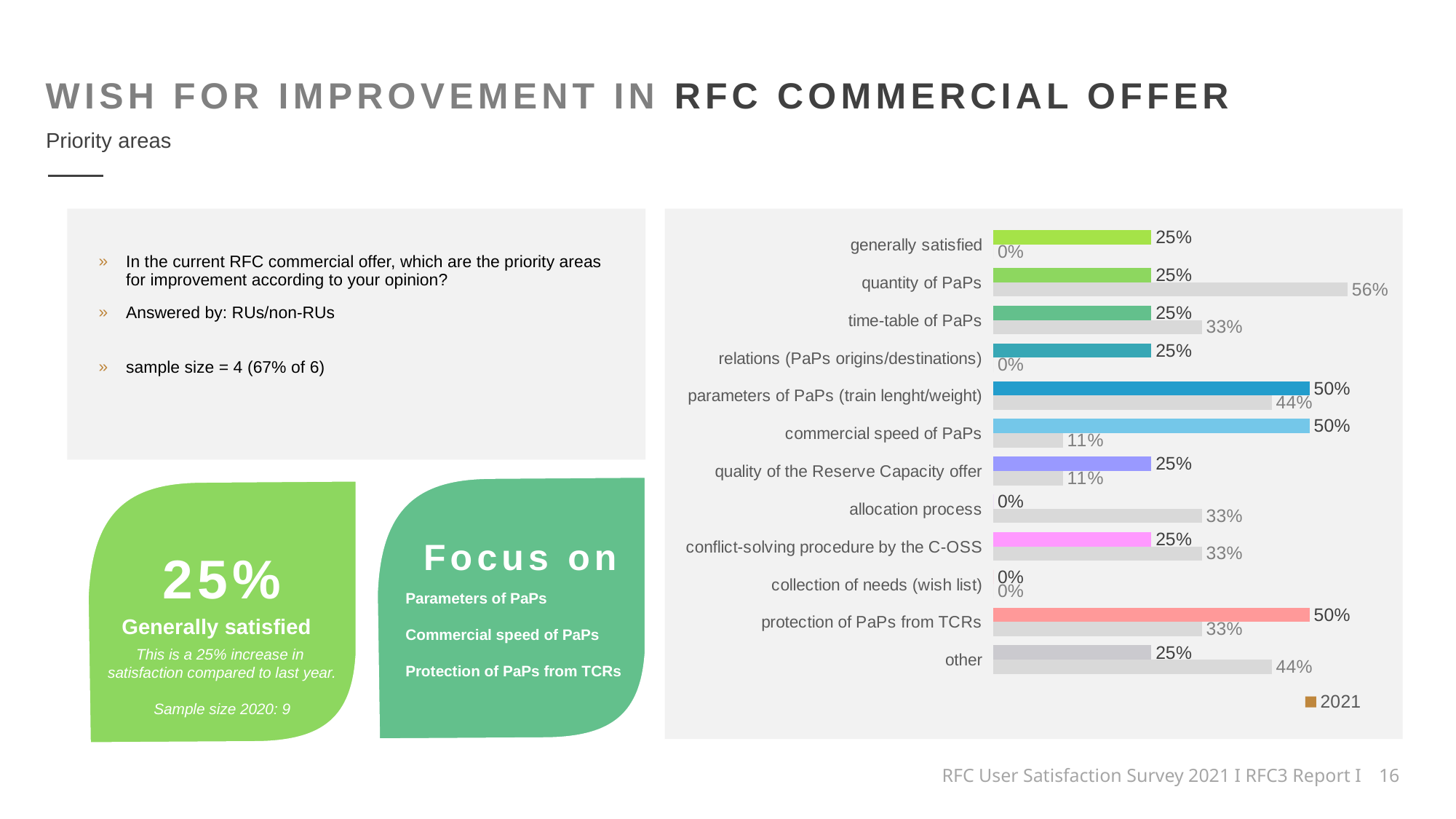
How many series does the chart legend list? 1 What is the 2021 value for "commercial speed of PaPs"? 50% What value is shown on the grey bar for "other"? 44% What kind of chart is shown on the slide? bar chart Which has the larger 2021 value: "protection of PaPs from TCRs" or "allocation process"? protection of PaPs from TCRs What value is shown on the grey bar for "quantity of PaPs"? 56% How many categories are shown in the chart? 12 What is the entry shown in the chart legend? 2021 For "parameters of PaPs (train lenght/weight)", what is the difference between the 2021 value and the grey bar value? 6 percentage points What is the 2021 value for "allocation process"? 0% Which category has the highest value among the grey bars? quantity of PaPs For "quantity of PaPs", how much larger is the grey bar value than the 2021 value? 31 percentage points